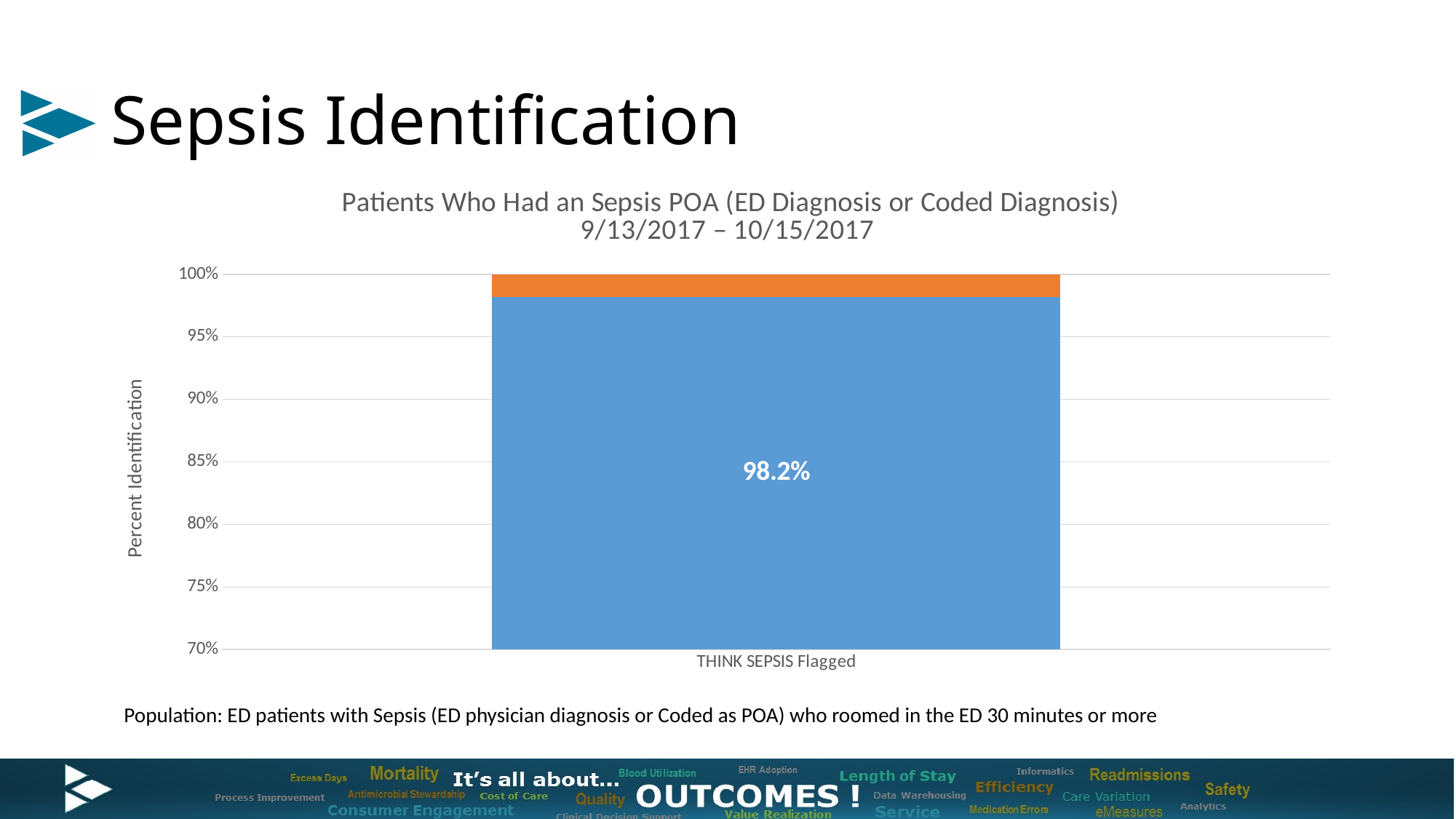
How many categories are plotted on the x axis of the chart? 1 What is the label on the y axis of the chart? Percent Identification What value is labeled on the blue segment of the bar for THINK SEPSIS Flagged? 98.2% What is the highest value shown on the y axis of the chart? 100% What is the title of the chart? Patients Who Had an Sepsis POA (ED Diagnosis or Coded Diagnosis) 9/13/2017 – 10/15/2017 What kind of chart is shown on the slide? bar chart Is the value of the blue segment for THINK SEPSIS Flagged greater or less than 95%? greater Is the value of the blue segment for THINK SEPSIS Flagged greater or less than 100%? less What is the total height of the stacked bar for THINK SEPSIS Flagged? 100% What is the difference between the total height of the stacked bar (100%) and the blue segment value of 98.2%? 1.8% What is the lowest value shown on the y axis of the chart? 70%